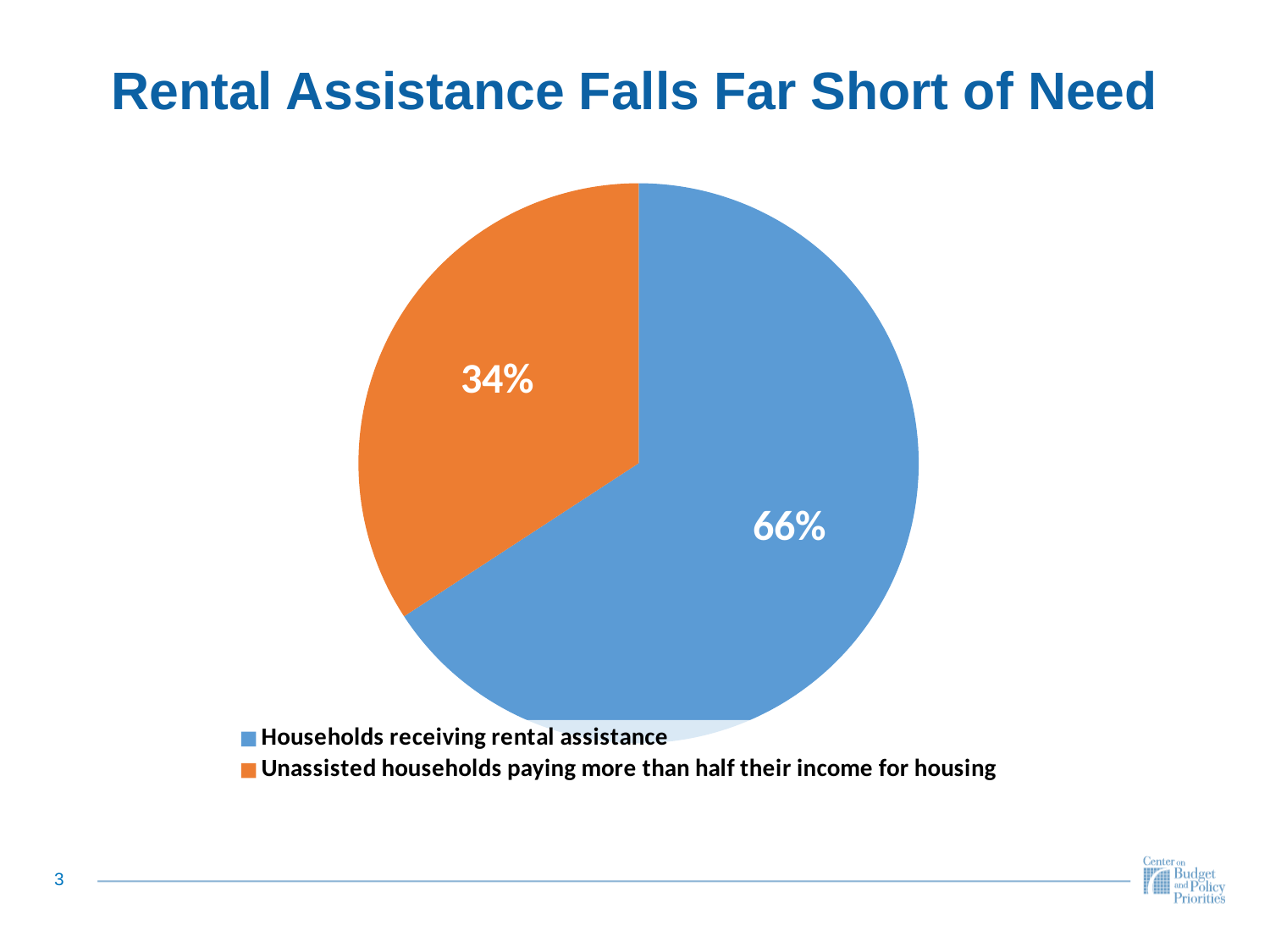
Which slice of the pie is the largest? Households receiving rental assistance What is the total of the two percentages shown on the pie chart? 100% What share of the pie is labelled for households receiving rental assistance? 66% What kind of chart is shown on the slide? pie chart Which slice of the pie is the smallest? Unassisted households paying more than half their income for housing What share of the pie is labelled for unassisted households paying more than half their income for housing? 34% What colour is the slice for unassisted households paying more than half their income for housing? orange How many entries does the legend list? 2 How many slices does the pie chart have? 2 What is the difference in percentage points between the two slices of the pie? 32 What is the title of the slide containing the pie chart? Rental Assistance Falls Far Short of Need Which is larger: the share for households receiving rental assistance or the share for unassisted households paying more than half their income for housing? Households receiving rental assistance